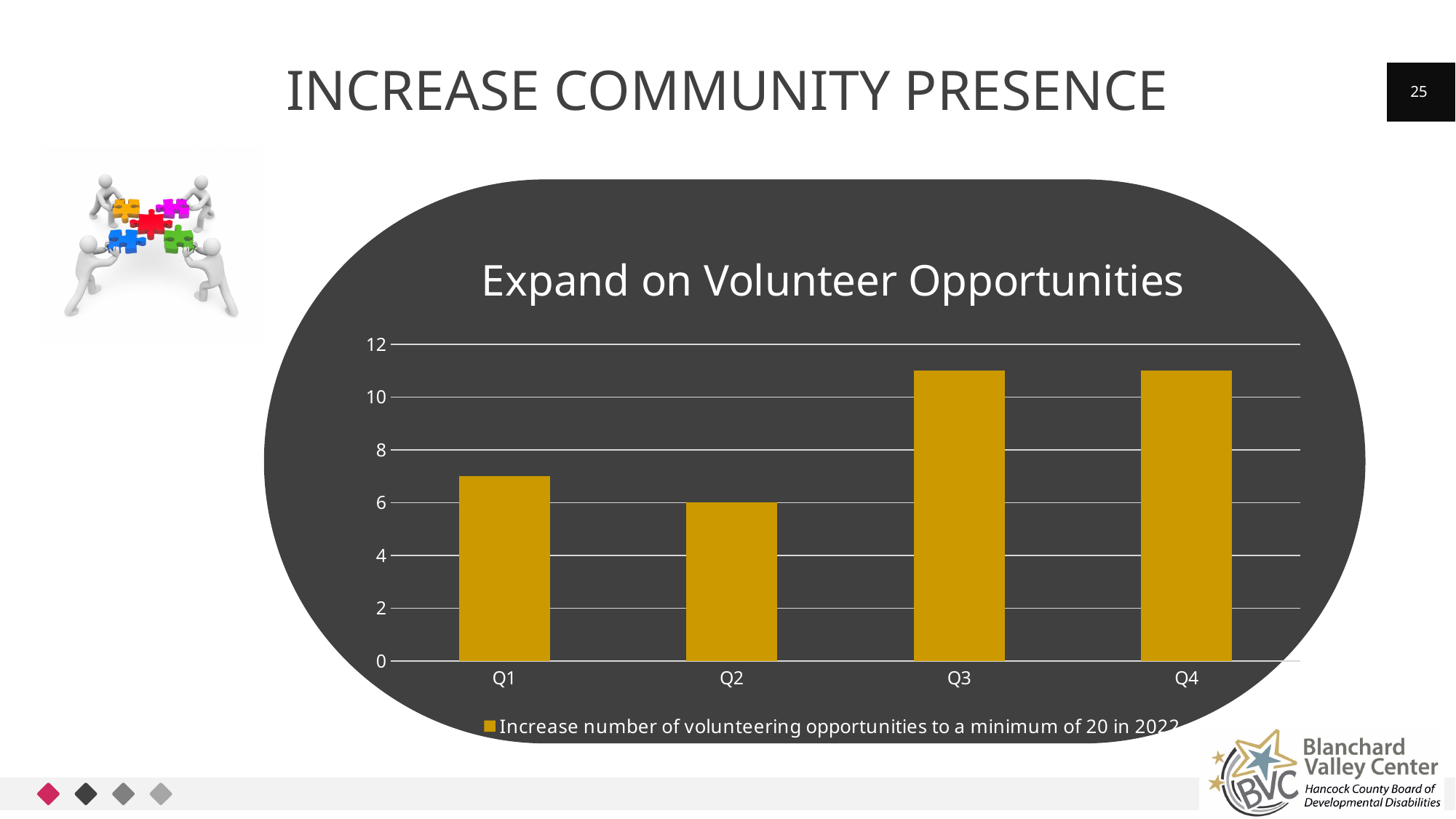
Does the value rise or fall from Q2 to Q3? rise What is the title of the chart? Expand on Volunteer Opportunities What is the legend entry shown below the chart? Increase number of volunteering opportunities to a minimum of 20 in 2022 How many series does the chart's legend list? 1 How many quarters are plotted on the x axis of the chart? 4 What is the value for Q2 in the chart? 6 What kind of chart is shown on the slide? Bar chart Is the value for Q4 greater or less than 10? greater Is the value for Q3 greater or less than 10? greater Which quarter has the lowest value in the chart? Q2 Is the value for Q1 greater or less than 8? less Which is larger, the value for Q1 or the value for Q3? Q3